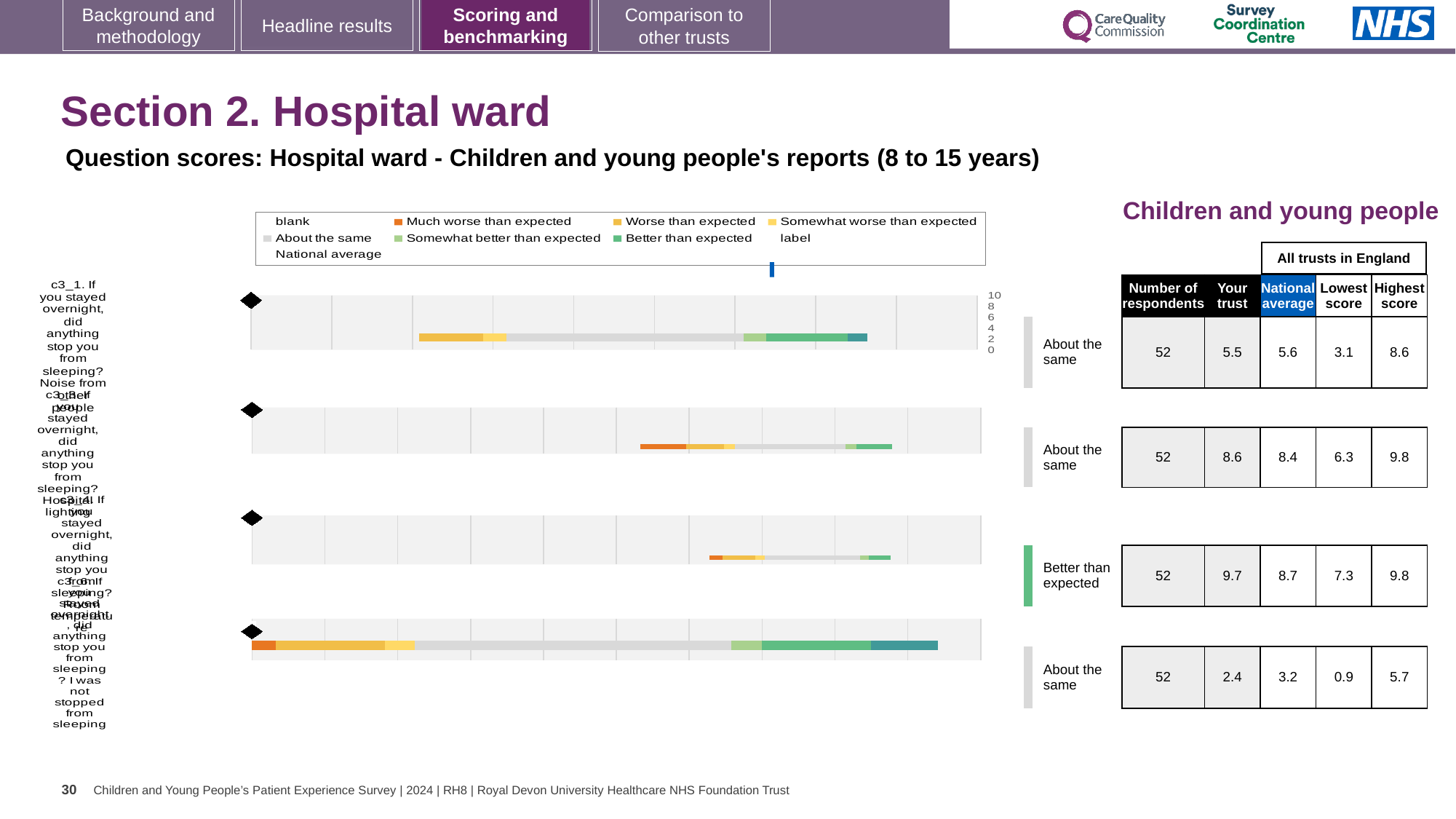
How many question rows (bars) does the chart show? 4 How many of the four rows are rated 'About the same'? 3 In the chart legend, what colour represents 'Better than expected'? green Which row has the highest 'Your trust' score in the table beside the chart? the third row (Better than expected), 9.7 In the table beside the chart, what is the national average for the fourth (bottom) row? 3.2 In the chart legend, what colour represents 'Much worse than expected'? orange For the second row, which is larger: the 'Your trust' score or the national average? Your trust (8.6) In the table beside the chart, how many respondents are listed for the first row? 52 In the table beside the chart, what is the 'Your trust' score for the third row (rated 'Better than expected')? 9.7 Which row has the lowest 'Your trust' score in the table beside the chart? the fourth (bottom) row, 2.4 For the third row, what is the difference between the 'Your trust' score (9.7) and the national average (8.7)? 1.0 What kind of chart is shown on the slide? bar chart